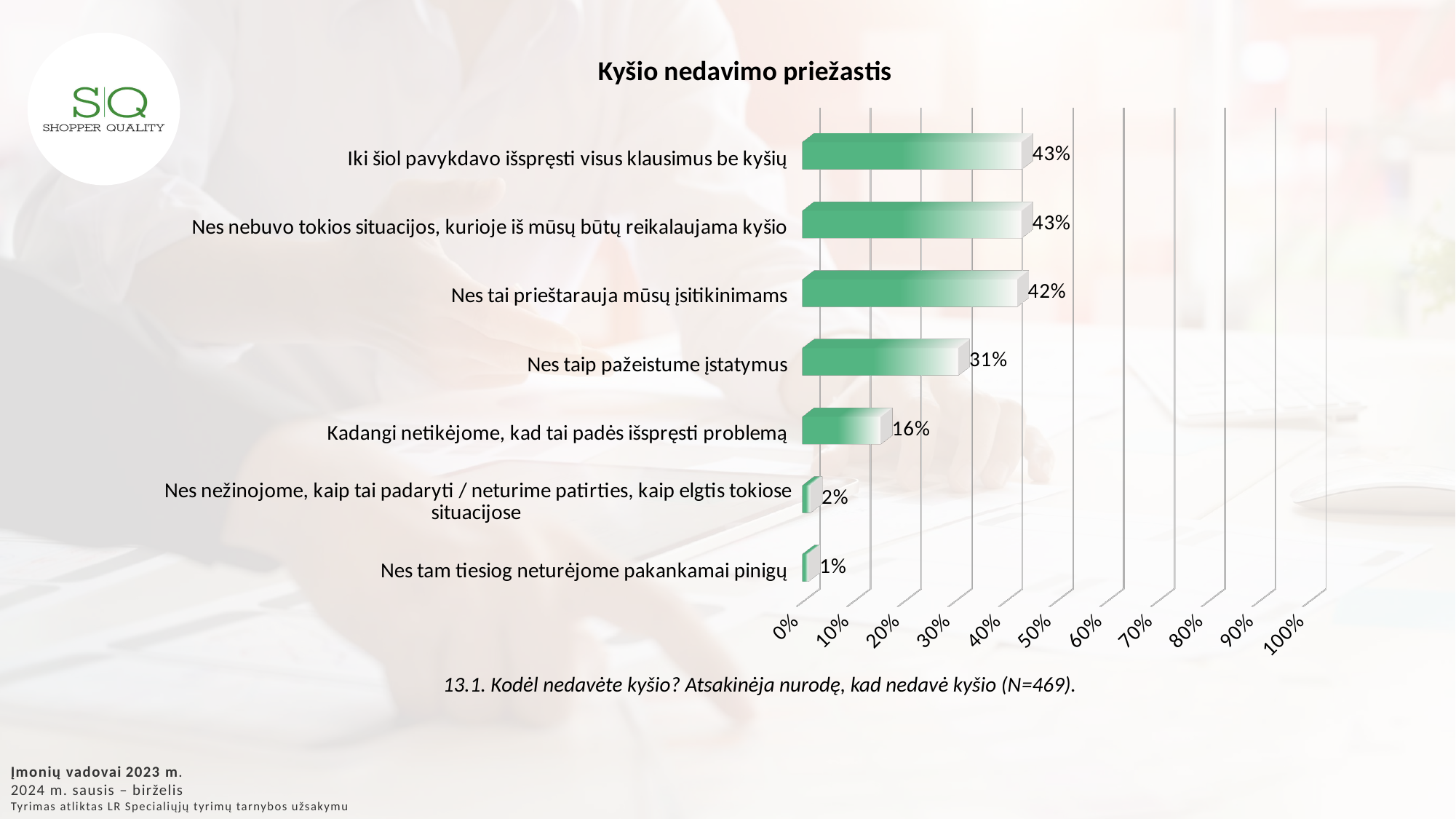
Which category has the lowest value? Nes tam tiesiog neturėjome pakankamai pinigų Which is larger: the value for "Nes tai prieštarauja mūsų įsitikinimams" or the value for "Nes taip pažeistume įstatymus"? Nes tai prieštarauja mūsų įsitikinimams Is the value for "Nes nebuvo tokios situacijos, kurioje iš mūsų būtų reikalaujama kyšio" greater or less than 50%? less What kind of chart is shown on the slide? bar chart What is the value for "Nes tai prieštarauja mūsų įsitikinimams"? 42% How many categories are shown in the chart? 7 What is the difference between the values for "Nes taip pažeistume įstatymus" and "Kadangi netikėjome, kad tai padės išspręsti problemą"? 15% What is the value for "Kadangi netikėjome, kad tai padės išspręsti problemą"? 16% What is the value for "Nes tam tiesiog neturėjome pakankamai pinigų"? 1% What is the value for "Nes taip pažeistume įstatymus"? 31% What is the difference between the values for "Iki šiol pavykdavo išspręsti visus klausimus be kyšių" and "Nes taip pažeistume įstatymus"? 12% What is the title of the chart? Kyšio nedavimo priežastis